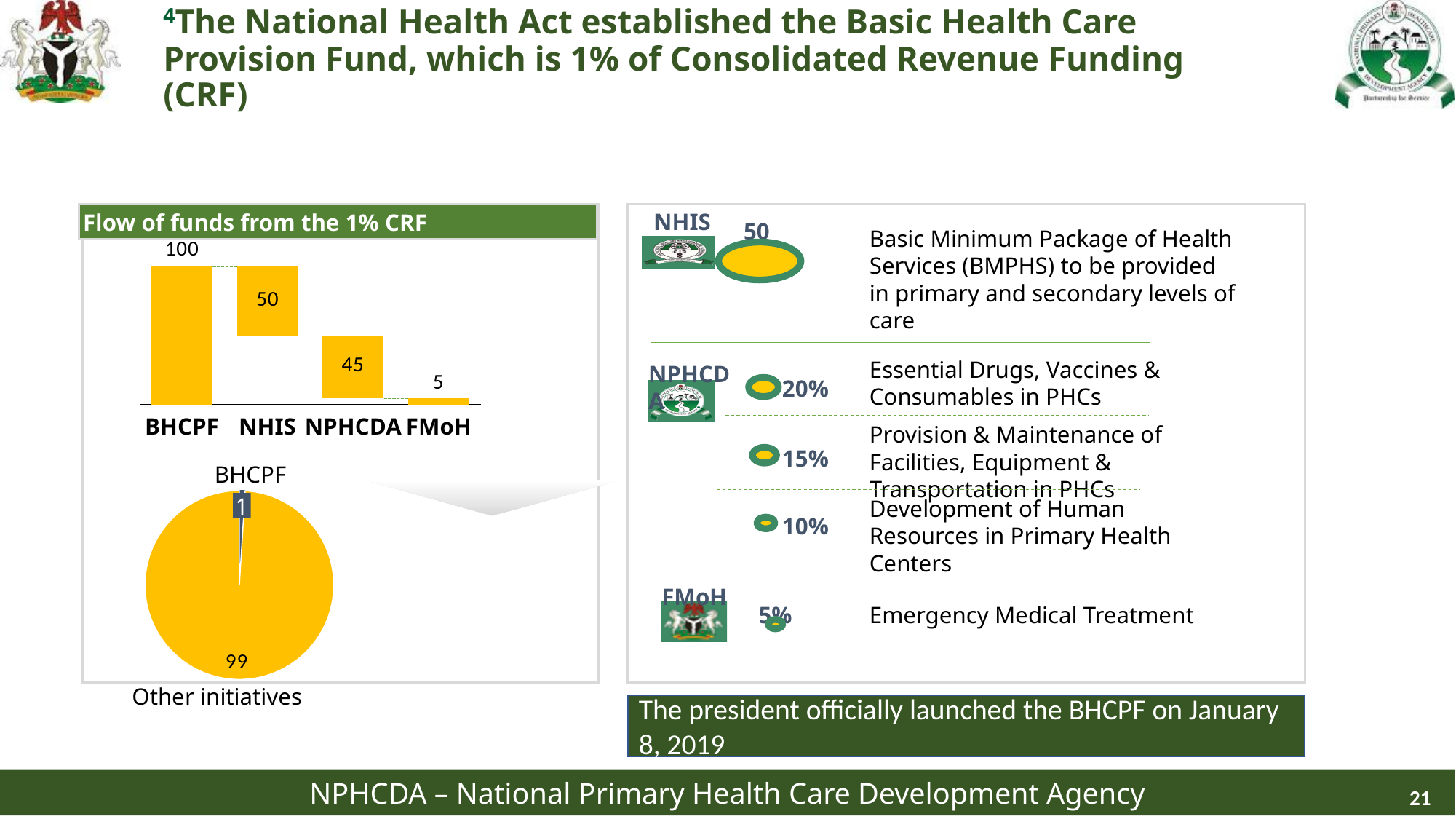
In the bar chart titled 'Flow of funds from the 1% CRF', what is the value for NHIS? 50 In the bar chart titled 'Flow of funds from the 1% CRF', what is the value for FMoH? 5 In the bar chart titled 'Flow of funds from the 1% CRF', which category has the lowest value? FMoH In the bar chart titled 'Flow of funds from the 1% CRF', which category has the highest value? BHCPF In the pie chart at the bottom left of the slide, what is the value for Other initiatives? 99 In the bar chart titled 'Flow of funds from the 1% CRF', what is the value for NPHCDA? 45 In the bar chart titled 'Flow of funds from the 1% CRF', do the values rise or fall from left to right? fall In the pie chart at the bottom left of the slide, what is the value for BHCPF? 1 How many categories are shown in the bar chart titled 'Flow of funds from the 1% CRF'? 4 What kind of chart is the chart titled 'Flow of funds from the 1% CRF'? bar chart In the bar chart titled 'Flow of funds from the 1% CRF', what is the difference between the values for BHCPF and NHIS? 50 In the bar chart titled 'Flow of funds from the 1% CRF', which is larger, the value for NHIS or the value for NPHCDA? NHIS